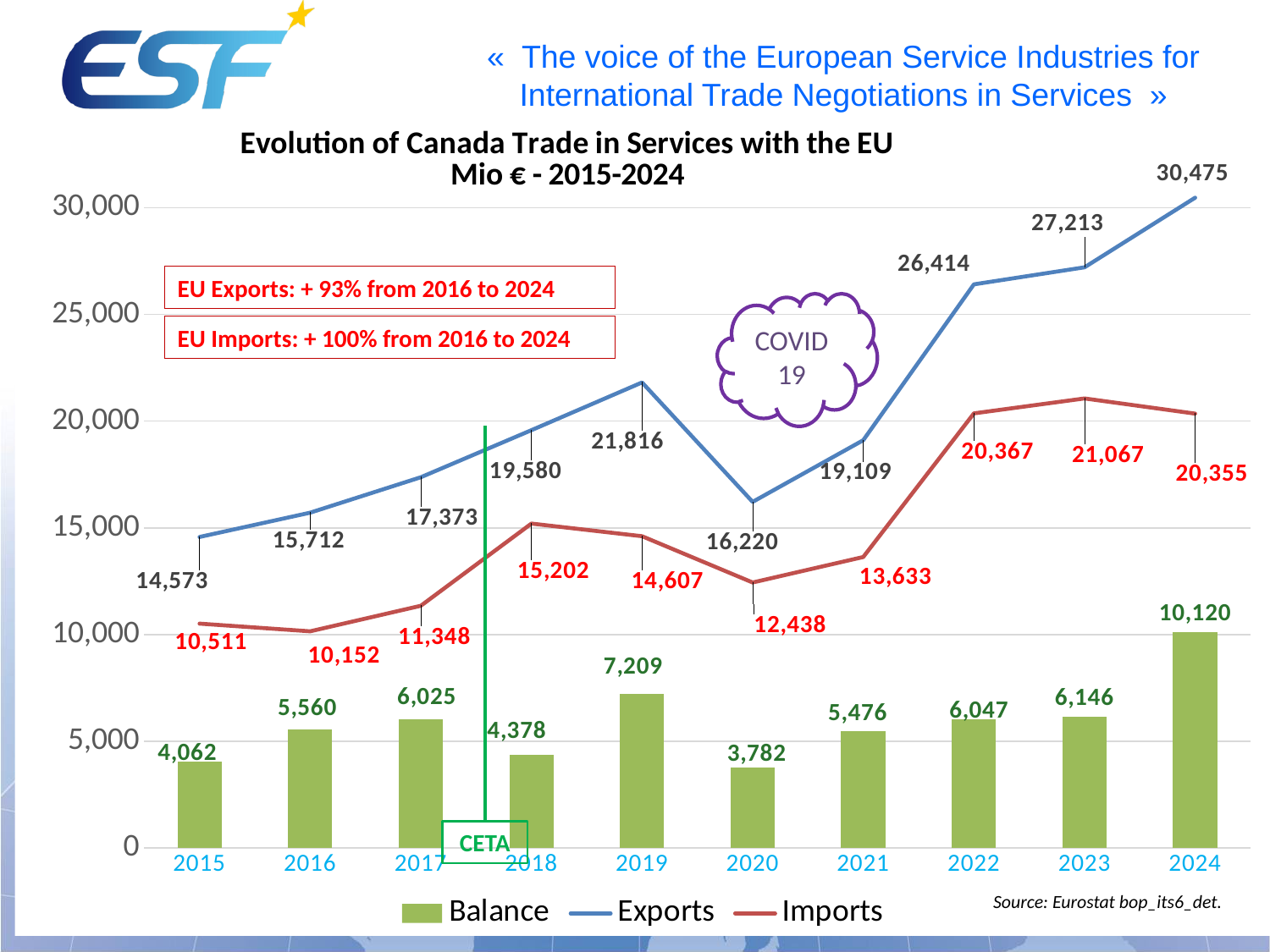
By how much did Exports fall from 2019 to 2020? 5,596 What was the Balance in 2018? 4,378 How many years are shown on the x axis? 10 In which year were Imports lowest? 2016 How many series does the legend list? 3 In which year were Exports highest? 2024 What was the value of Exports in 2019? 21,816 What was the value of Imports in 2022? 20,367 Which was larger in 2021, Exports or Imports? Exports In which year was the Balance lowest? 2020 What kind of chart is shown on the slide? Combined bar and line chart What is the difference between Exports and Imports in 2024? 10,120